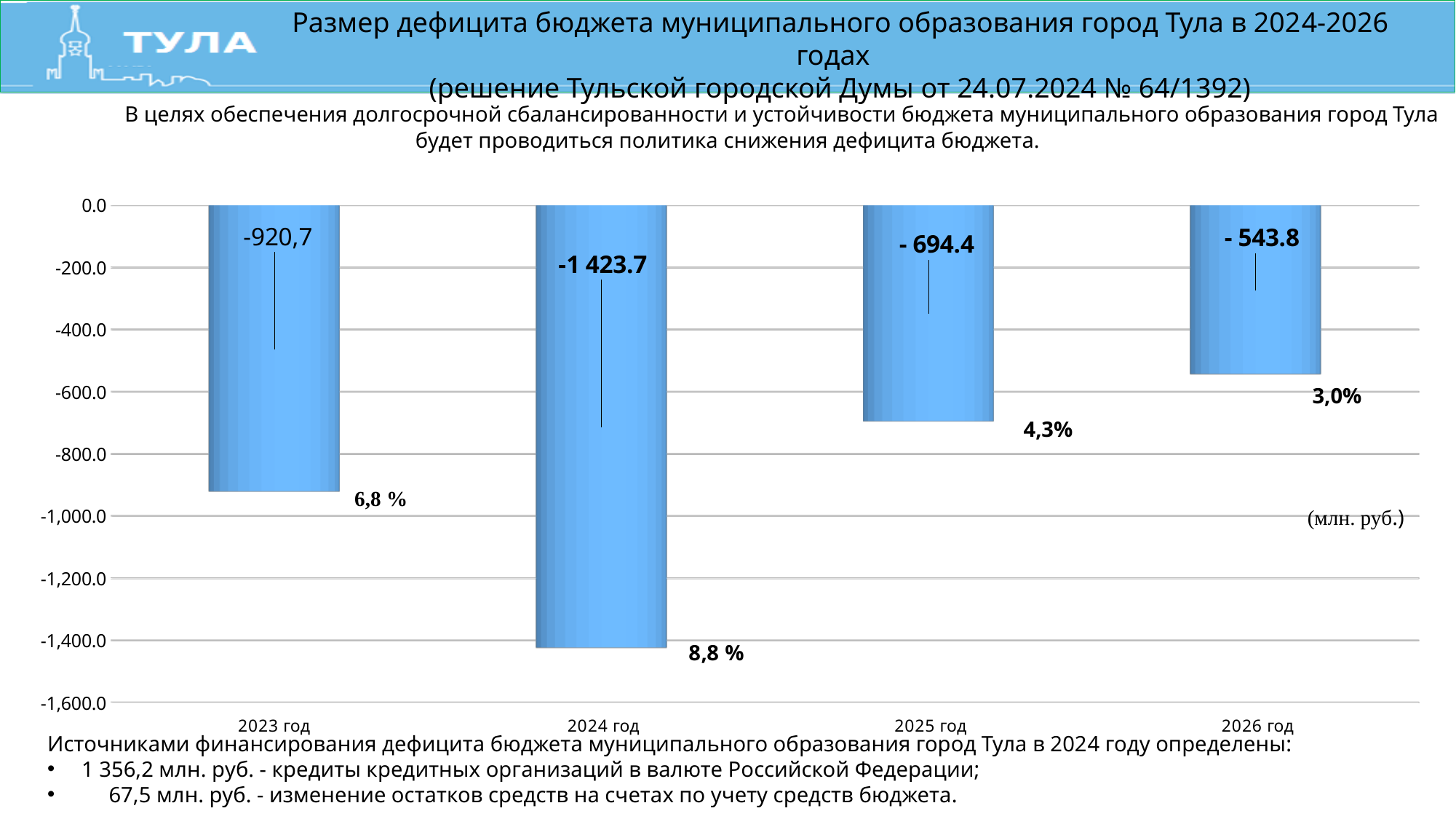
By how much does the deficit for 2025 год exceed the deficit for 2026 год, in absolute terms? 150.6 What is the value shown for 2024 год? -1 423.7 Which year has the smallest budget deficit (the shortest bar)? 2026 год How many years are shown on the x axis of the chart? 4 What percentage label is shown next to the bar for 2025 год? 4,3% Is the value for 2025 год greater or less than -600.0? less What is the value shown for 2026 год? - 543.8 What is the value shown for 2023 год? -920,7 What unit is indicated on the chart for the plotted values? млн. руб. Which year has the largest budget deficit (the longest bar)? 2024 год What type of chart is shown on the slide? bar chart Which bar is longer, 2023 год or 2025 год? 2023 год